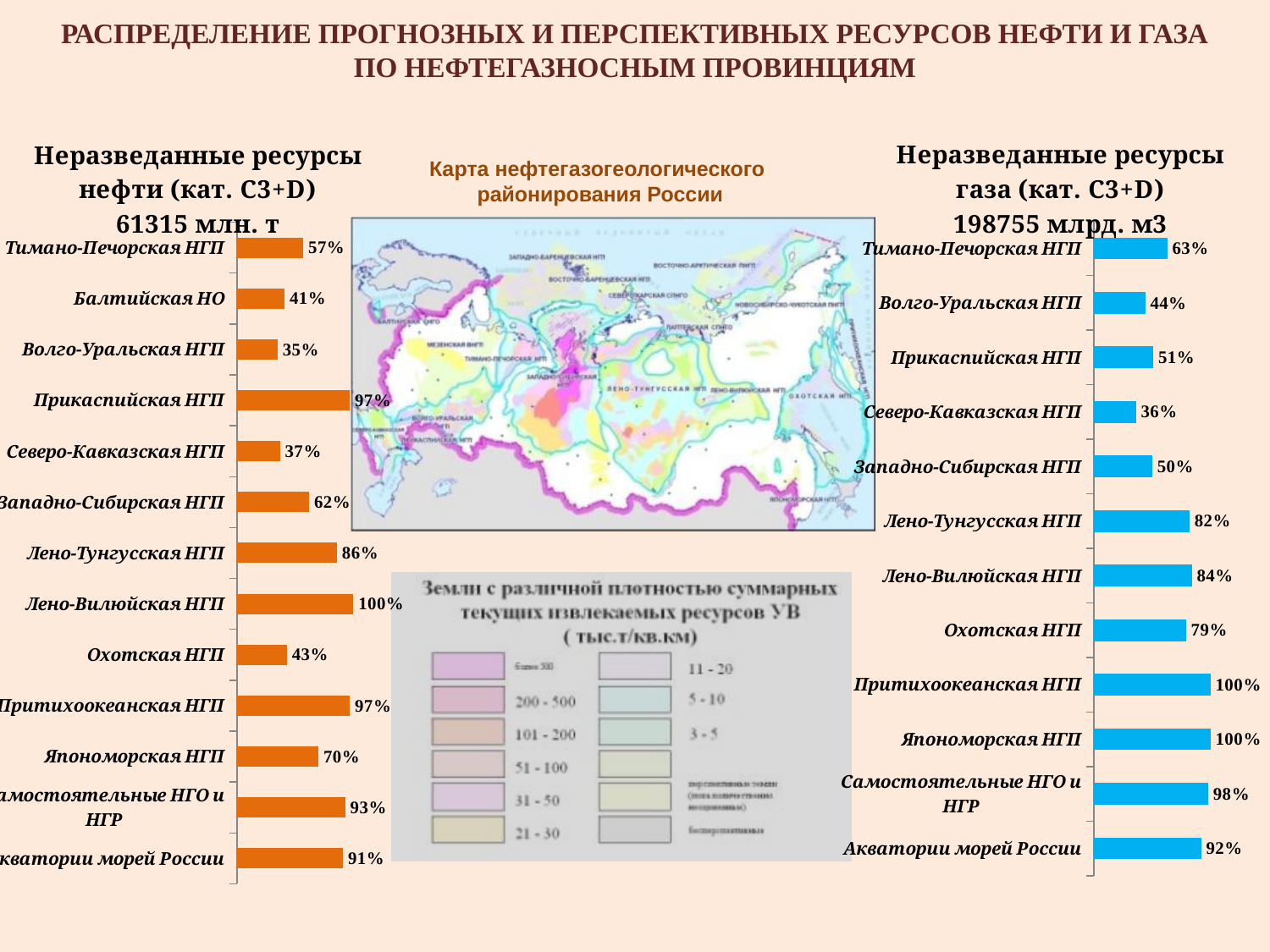
What total is stated in the title of the oil chart (Неразведанные ресурсы нефти)? 61315 млн. т In the gas chart (Неразведанные ресурсы газа), which category has the lowest value? Северо-Кавказская НГП In the oil chart (Неразведанные ресурсы нефти), which is larger: Западно-Сибирская НГП or Япономорская НГП? Япономорская НГП In the gas chart (Неразведанные ресурсы газа), what is the value for Лено-Тунгусская НГП? 82% What type of chart is used for the gas resources (Неразведанные ресурсы газа)? Bar chart How many categories are shown in the oil chart (Неразведанные ресурсы нефти)? 13 In the oil chart (Неразведанные ресурсы нефти), which category has the highest value? Лено-Вилюйская НГП In the gas chart (Неразведанные ресурсы газа), what is the difference between Лено-Вилюйская НГП and Волго-Уральская НГП? 40% In the oil chart (Неразведанные ресурсы нефти), what is the value for Прикаспийская НГП? 97% In the oil chart (Неразведанные ресурсы нефти), which category has the lowest value? Волго-Уральская НГП In the gas chart (Неразведанные ресурсы газа), which is larger: Охотская НГП or Прикаспийская НГП? Охотская НГП How many categories are shown in the gas chart (Неразведанные ресурсы газа)? 12